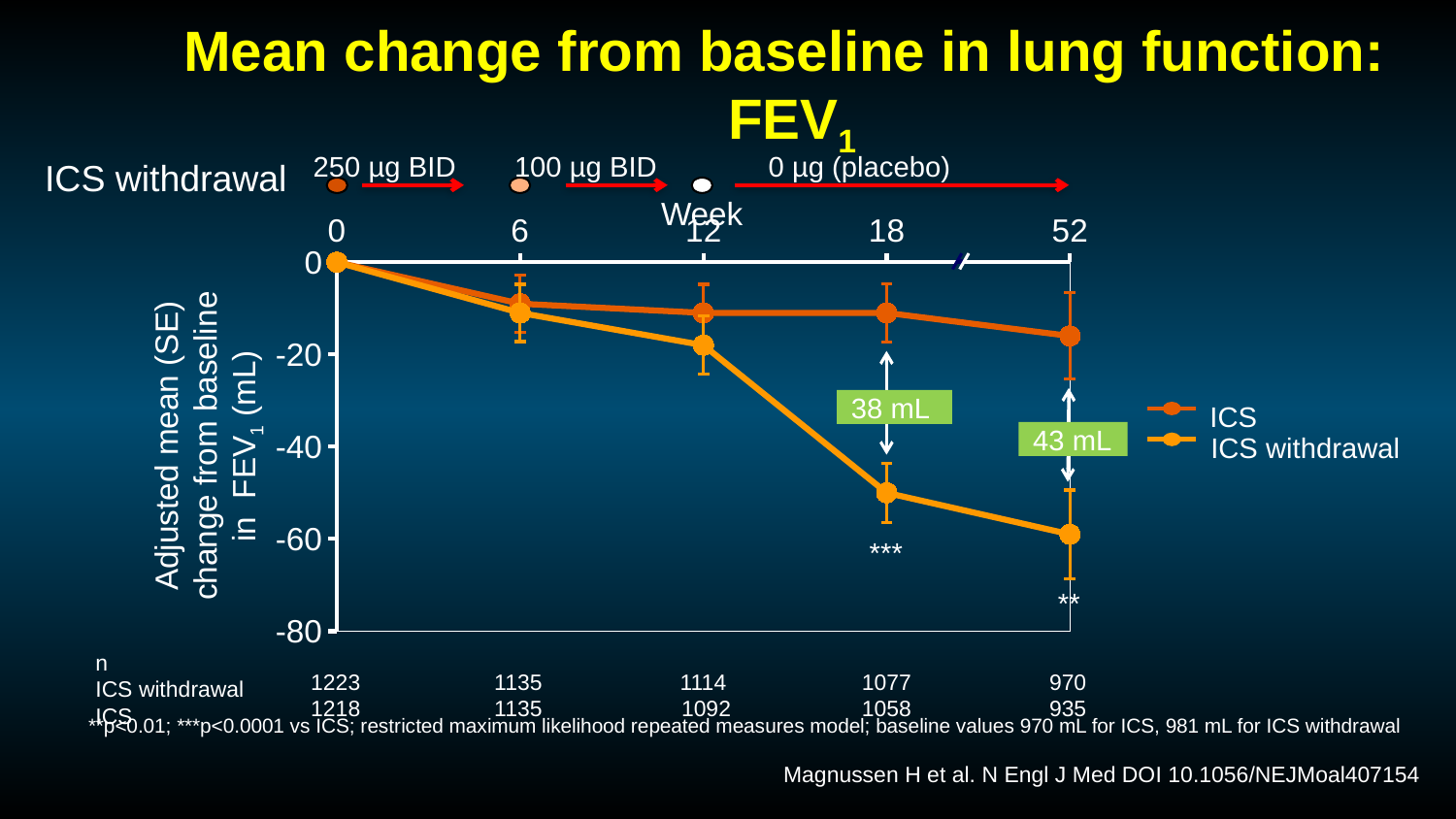
How many time points (weeks) are plotted on the x axis? 5 How many series does the legend list? 2 Is the value for ICS withdrawal at week 18 greater or less than -40? less Which series reaches the lowest value on the chart? ICS withdrawal What is the labelled difference between the ICS and ICS withdrawal groups at week 18? 38 mL What kind of chart is shown on the slide? line chart What is the labelled difference between the ICS and ICS withdrawal groups at week 52? 43 mL Is the value for ICS at week 52 greater or less than -20? greater Is the value for ICS withdrawal at week 52 greater or less than -40? less Do the values for ICS withdrawal rise or fall from week 0 to week 52? fall At week 52, which series has the higher value, ICS or ICS withdrawal? ICS What are the two entries in the chart legend? ICS and ICS withdrawal